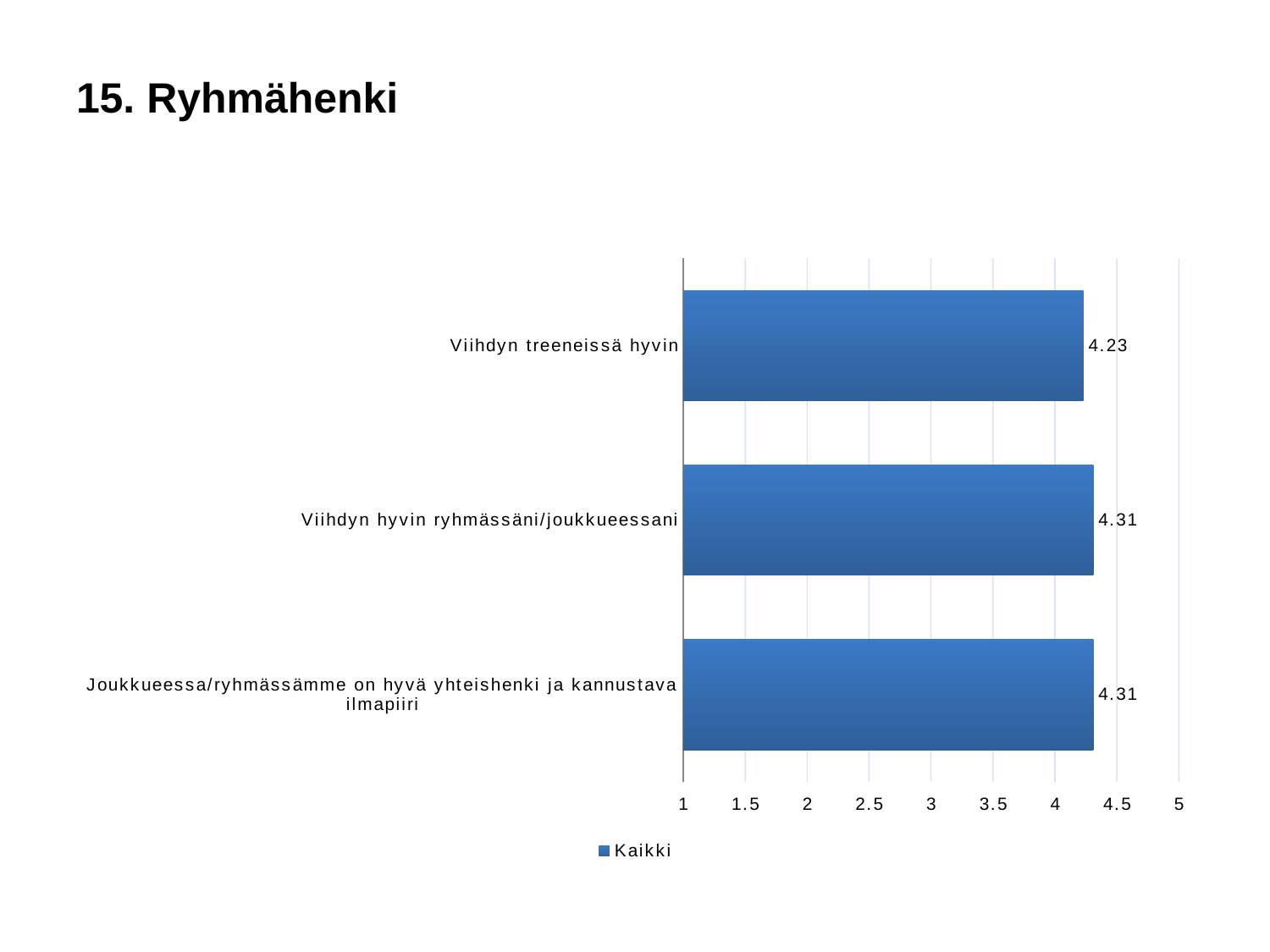
How many categories are shown in the chart? 3 Is the value for "Viihdyn treeneissä hyvin" greater or less than 4.5? less Is the value for "Joukkueessa/ryhmässämme on hyvä yhteishenki ja kannustava ilmapiiri" greater or less than 4? greater What is the value for "Viihdyn hyvin ryhmässäni/joukkueessani"? 4.31 What is the value for "Viihdyn treeneissä hyvin"? 4.23 What kind of chart is shown on the slide? bar chart Which is larger: the value for "Viihdyn treeneissä hyvin" or the value for "Viihdyn hyvin ryhmässäni/joukkueessani"? Viihdyn hyvin ryhmässäni/joukkueessani What is the name of the series shown in the legend? Kaikki What is the difference between the values for "Viihdyn hyvin ryhmässäni/joukkueessani" and "Viihdyn treeneissä hyvin"? 0.08 How many series does the legend list? 1 Which category has the lowest value? Viihdyn treeneissä hyvin What is the value for "Joukkueessa/ryhmässämme on hyvä yhteishenki ja kannustava ilmapiiri"? 4.31